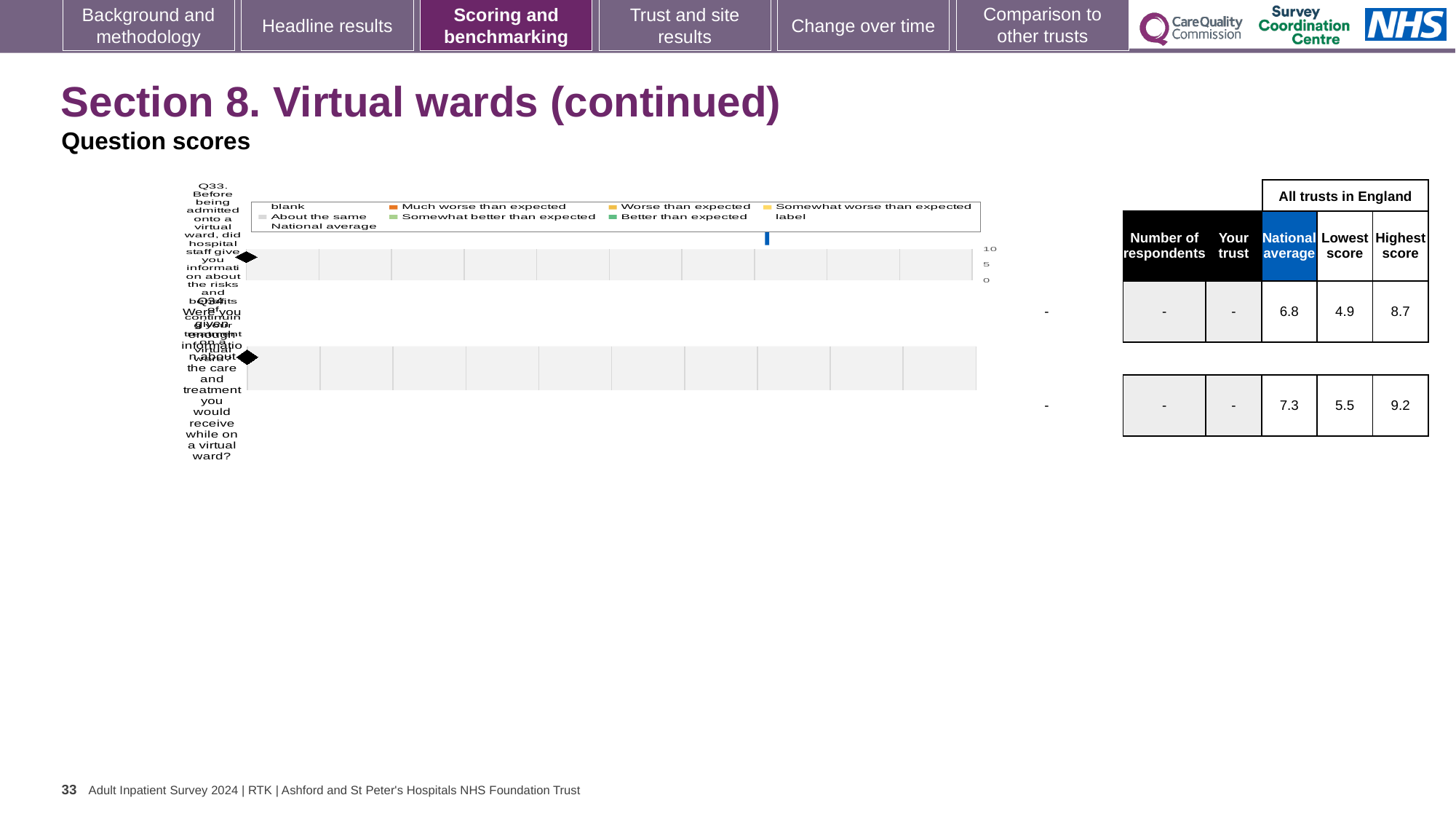
What is the lowest score among all trusts in England for Q33? 4.9 What is the highest value shown on the chart's score axis? 10 What is the lowest score among all trusts in England for Q34? 5.5 Which question has the higher national average score, Q33 or Q34? Q34 How many questions (categories) are listed on the chart? 2 What is the national average score for Q34 (enough information about the care and treatment on a virtual ward)? 7.3 What is the national average score for Q33 (information about the risks and benefits of continuing treatment on a virtual ward)? 6.8 In the chart legend, what colour represents 'Much worse than expected'? orange What kind of chart is shown on the slide? bar chart What is the highest score among all trusts in England for Q33? 8.7 What is the highest score among all trusts in England for Q34? 9.2 What is the difference between the highest and lowest scores for Q33? 3.8